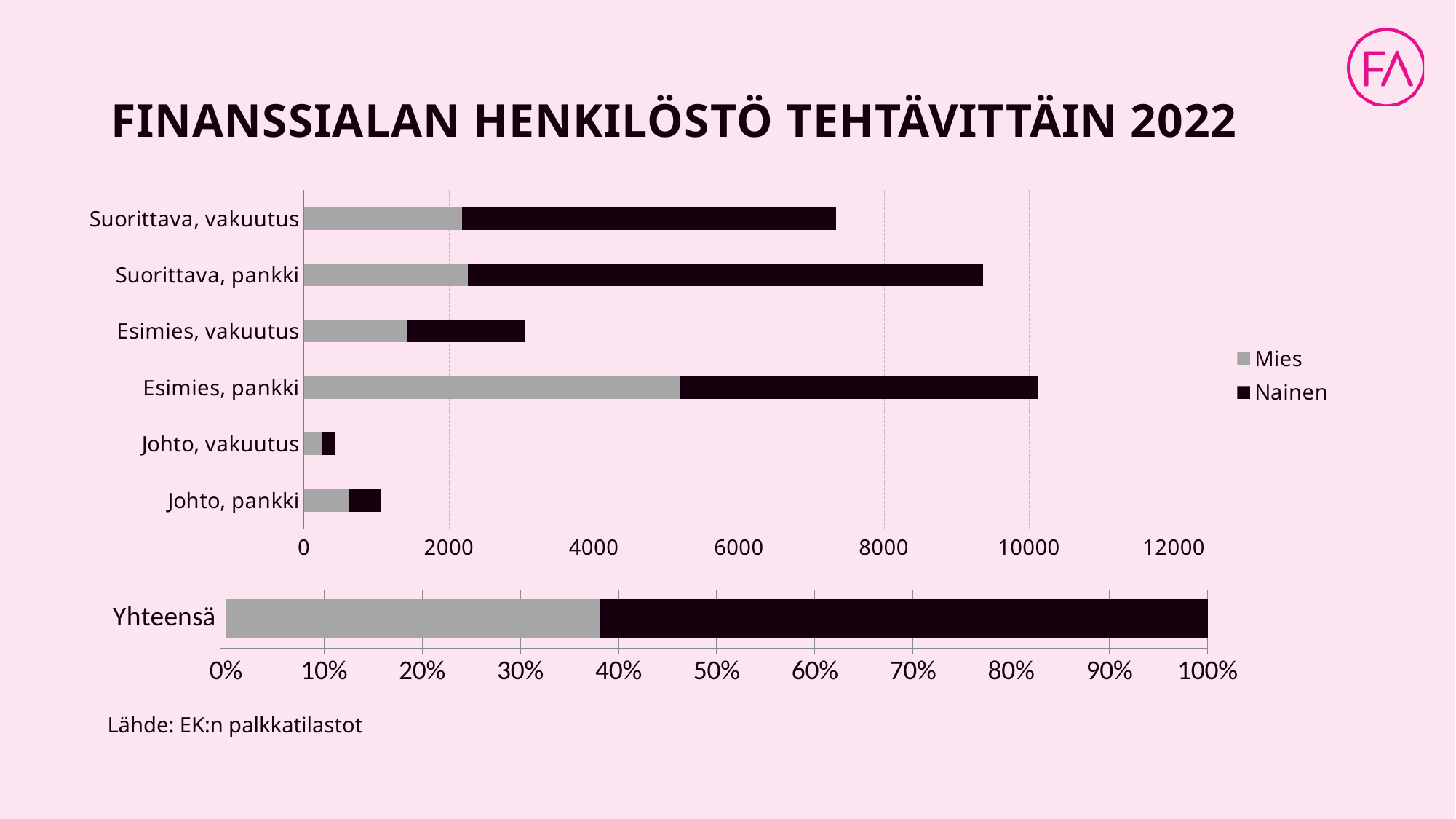
In the top chart, how many categories are shown? 6 In the bottom Yhteensä chart, is the Mies share greater or less than 40%? less What kind of chart is the top chart on the slide? bar chart In the top chart, which category has the shortest total bar? Johto, vakuutus In the top chart, is the total bar for Esimies, vakuutus greater or less than 2000? greater In the top chart, which category has the longest total bar? Esimies, pankki In the top chart, which has the larger total bar: Suorittava, pankki or Suorittava, vakuutus? Suorittava, pankki In the top chart, is the total bar for Suorittava, pankki greater or less than 8000? greater How many series does the legend list? 2 In the bottom Yhteensä chart, which series has the larger share: Mies or Nainen? Nainen